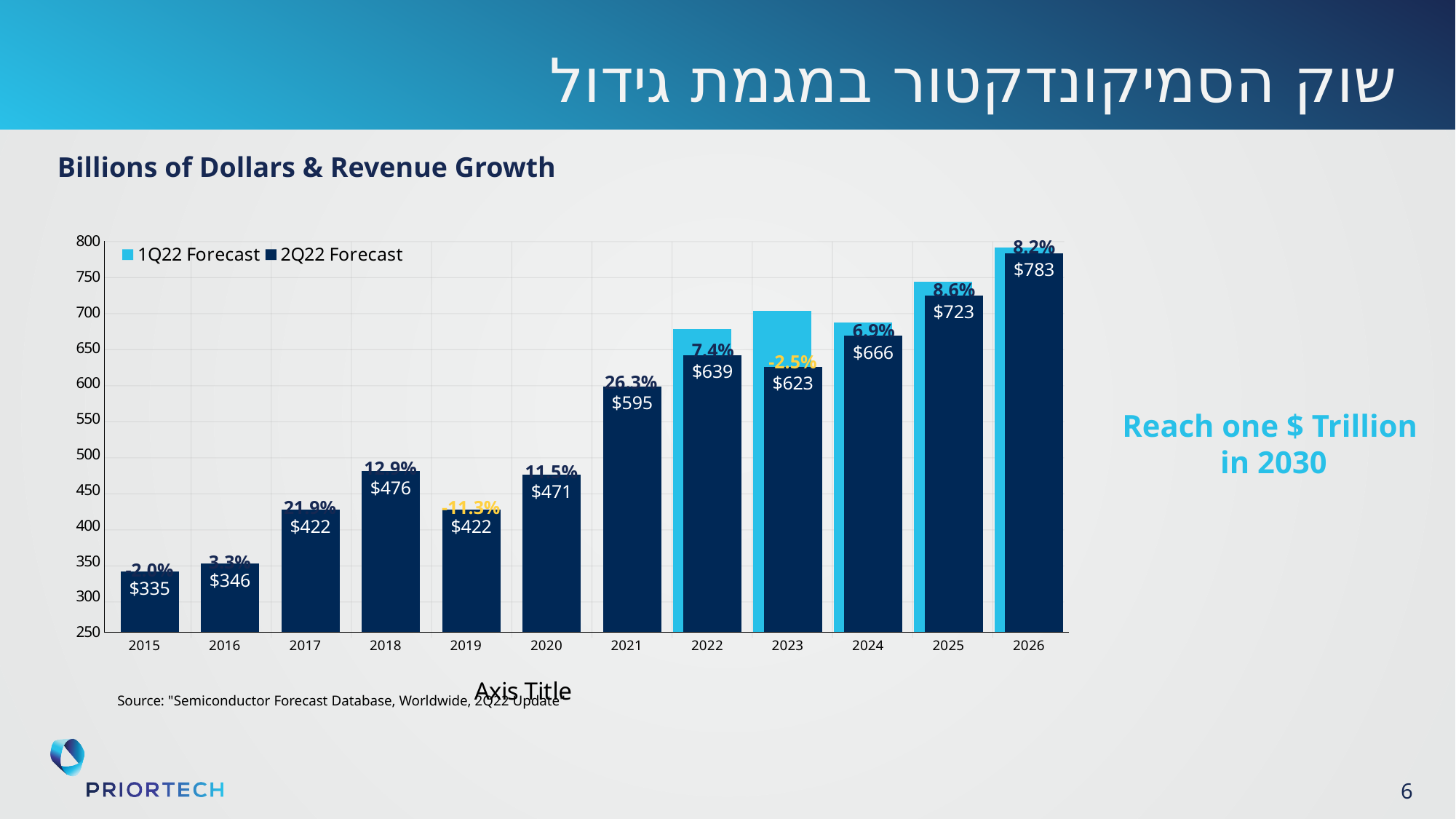
Which year has the highest 2Q22 Forecast value? 2026 Which year has the lowest 2Q22 Forecast value? 2015 What is the 2Q22 Forecast value for 2023? $623 What is the 2Q22 Forecast value for 2026? $783 Is the 1Q22 Forecast value for 2022 greater or less than 650? greater What kind of chart is shown on the slide? Bar chart What is the difference between the 2Q22 Forecast values for 2021 and 2020? $124 How many years are shown on the x axis? 12 What is the difference between the 2Q22 Forecast values for 2026 and 2015? $448 What is the 2Q22 Forecast value for 2015? $335 Which is larger, the 2Q22 Forecast value for 2022 or for 2023? 2022 How many series does the legend list? 2